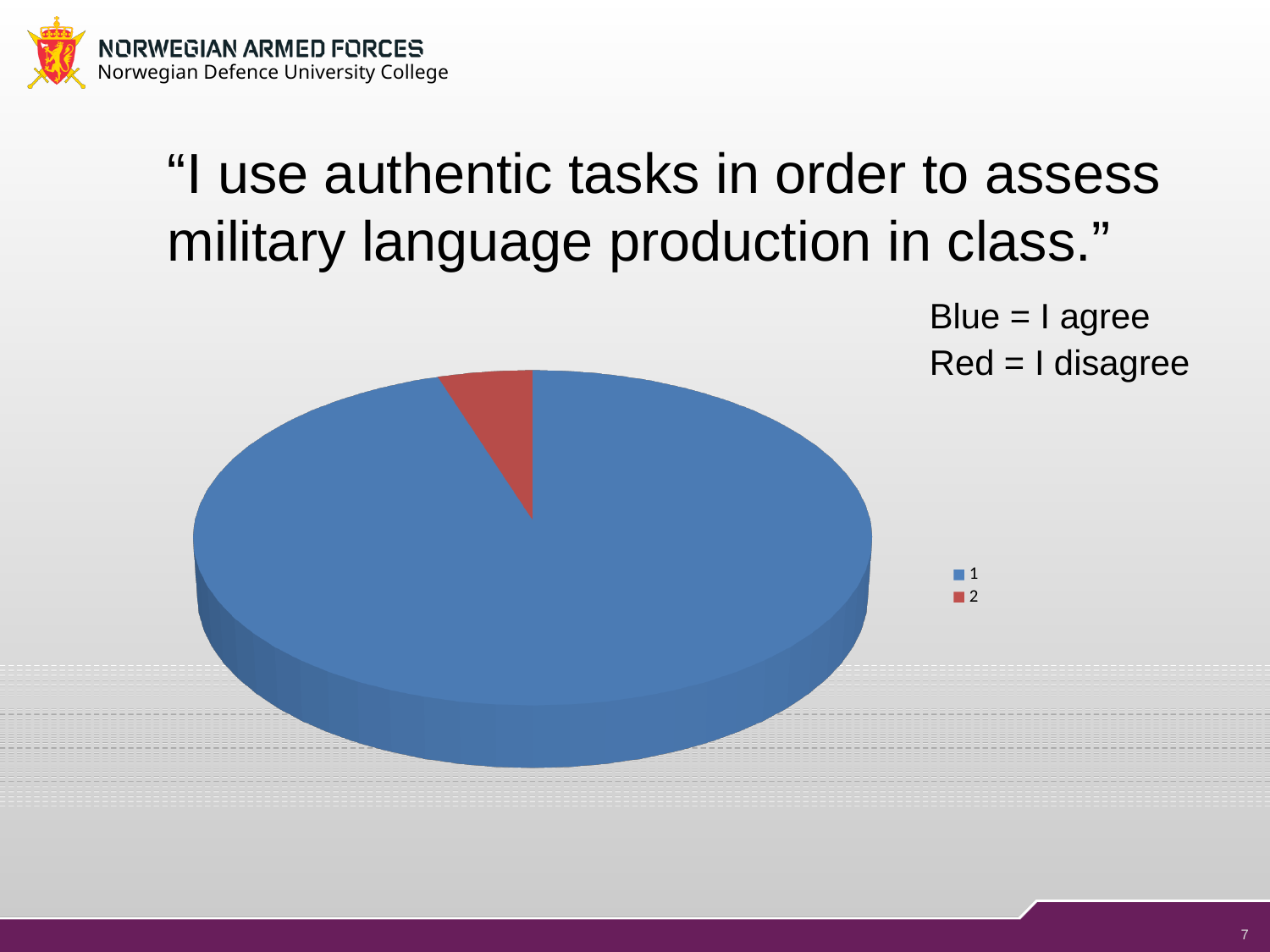
What kind of chart is shown on the slide? pie chart According to the slide, what response does the red slice represent? I disagree How many slices does the pie chart have? 2 Which legend category has the smallest slice in the pie chart? 2 Which legend category has the largest slice in the pie chart? 1 According to the slide, what response does the blue slice represent? I agree How many entries does the legend of the pie chart list? 2 Is the blue slice of the pie chart larger or smaller than the red slice? larger Which slice is larger in the pie chart, the blue one or the red one? the blue one